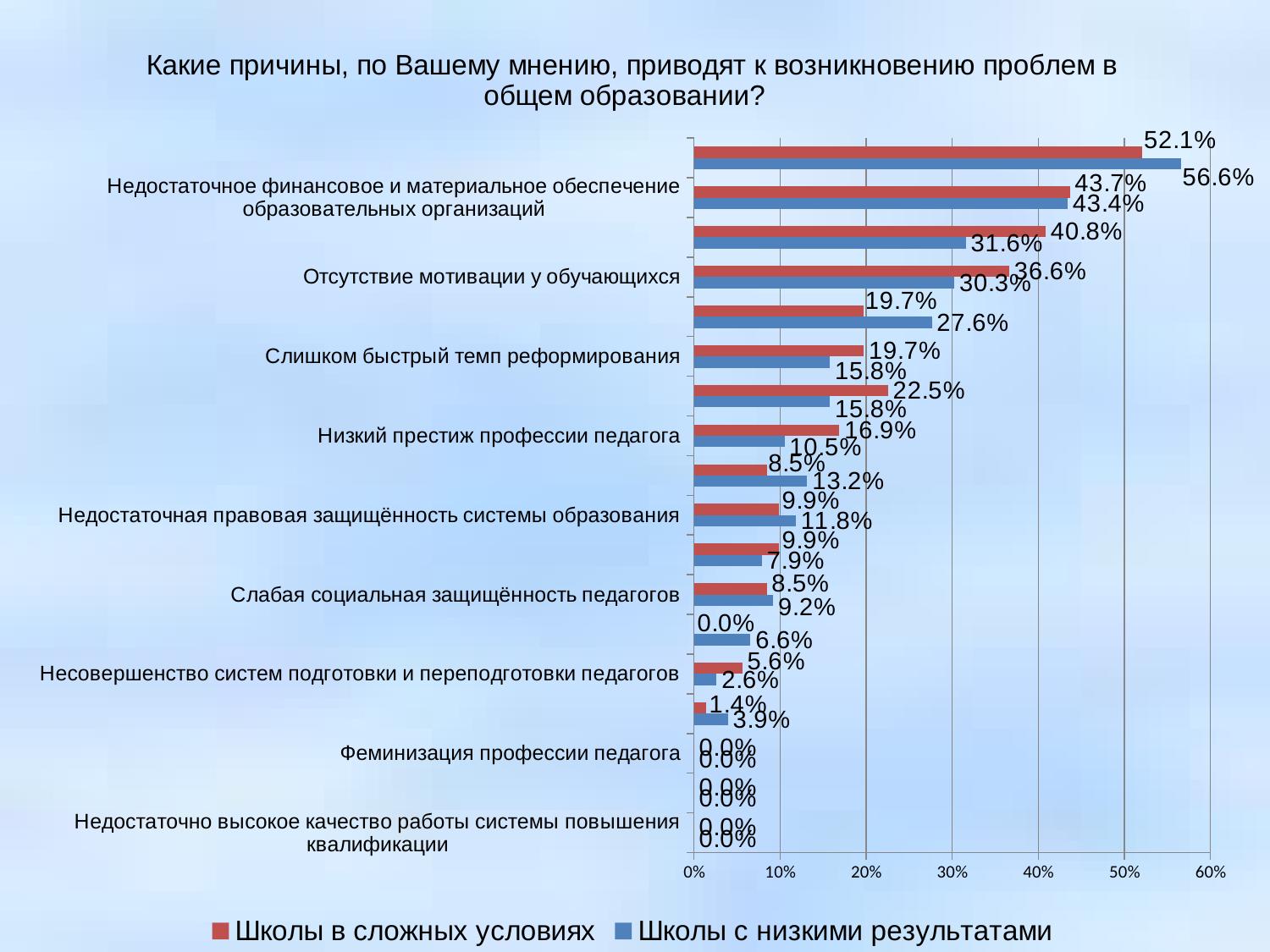
For 'Слабая социальная защищённость педагогов', which series has the larger value: 'Школы в сложных условиях' or 'Школы с низкими результатами'? Школы с низкими результатами What is the highest value shown for the 'Школы с низкими результатами' series? 56.6% Which colour represents the 'Школы в сложных условиях' series? red What is the value for 'Школы с низкими результатами' for 'Отсутствие мотивации у обучающихся'? 30.3% What is the value for 'Школы в сложных условиях' for 'Недостаточное финансовое и материальное обеспечение образовательных организаций'? 43.7% How many series does the legend list? 2 What is the value for 'Школы в сложных условиях' for 'Отсутствие мотивации у обучающихся'? 36.6% What is the highest value shown for the 'Школы в сложных условиях' series? 52.1% What is the difference between the 'Школы в сложных условиях' and 'Школы с низкими результатами' values for 'Низкий престиж профессии педагога'? 6.4% What is the value for 'Школы в сложных условиях' for 'Несовершенство систем подготовки и переподготовки педагогов'? 5.6% What is the value for 'Школы с низкими результатами' for 'Низкий престиж профессии педагога'? 10.5% What type of chart is shown on the slide? bar chart